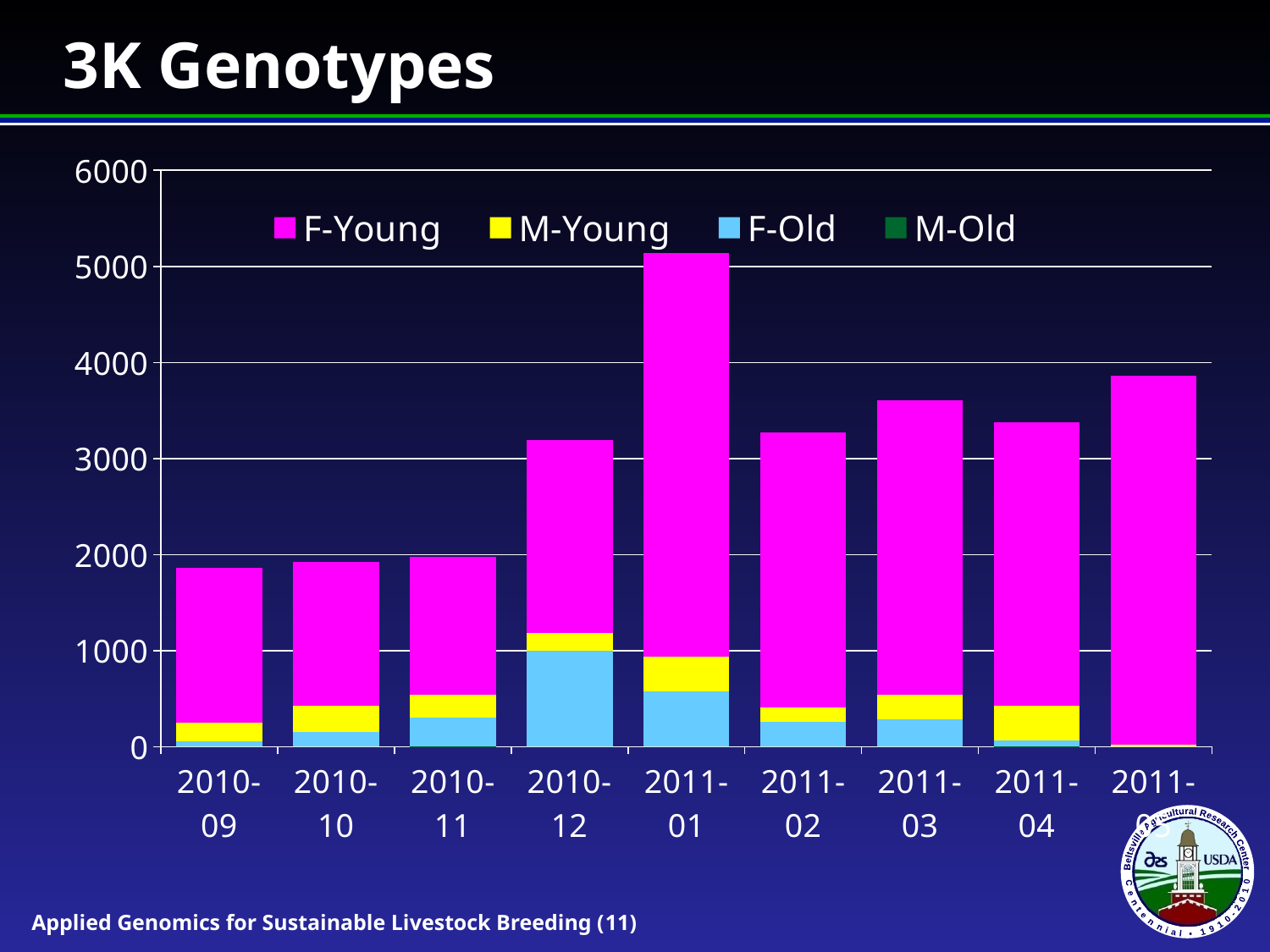
How many series does the legend list? 4 What kind of chart is shown on the slide? stacked bar chart Is the total for 2011-01 greater or less than 5000? greater How many months (categories) are shown on the x axis? 9 Which month has the largest F-Old segment? 2010-12 Is the total for 2011-03 greater or less than 4000? less Which has the larger total, 2011-01 or 2011-03? 2011-01 Which month has the highest total stacked bar? 2011-01 Is the total for 2010-12 greater or less than 3000? greater What is the title of the chart? 3K Genotypes Which has the larger total, 2010-11 or 2010-12? 2010-12